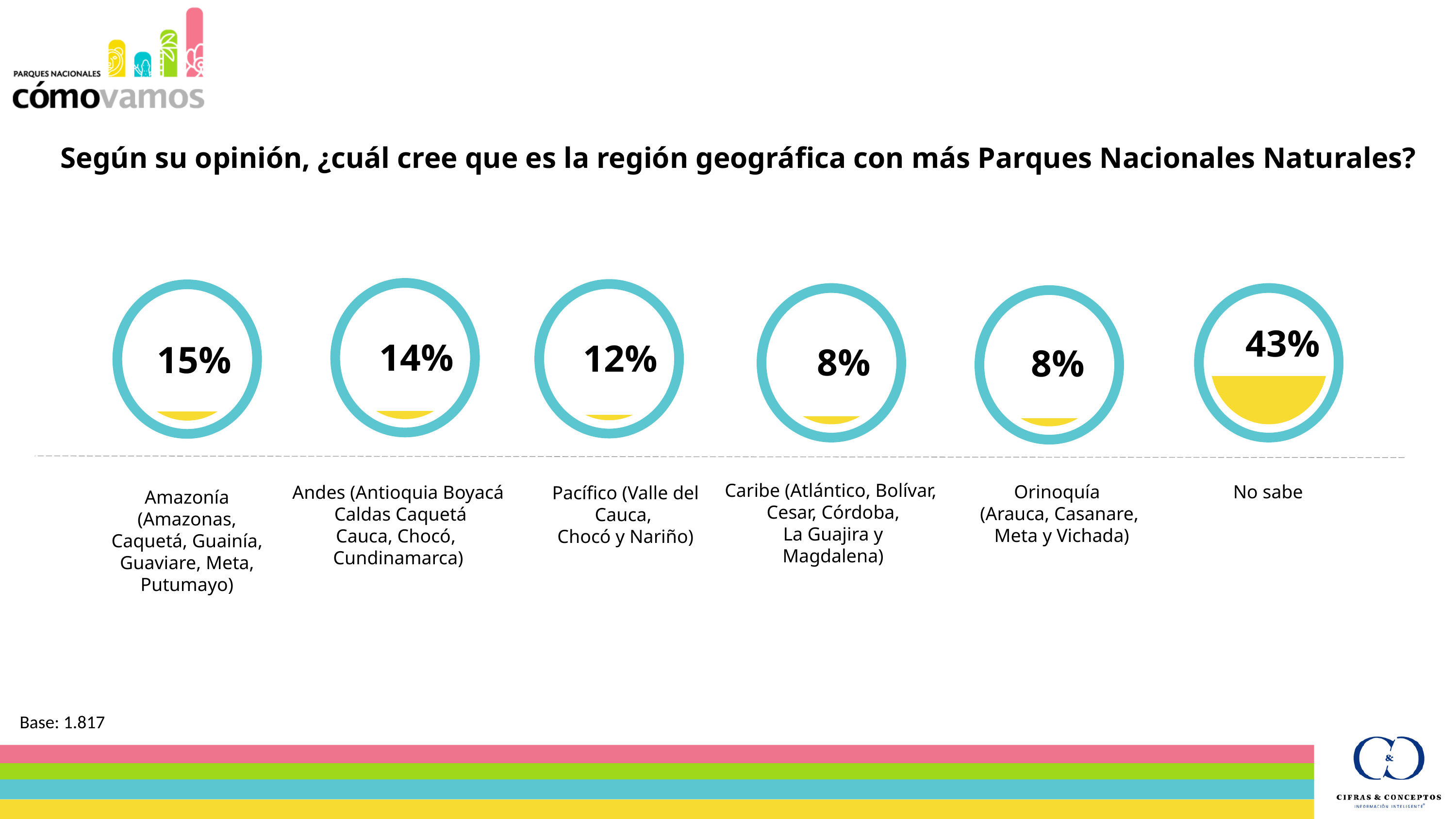
What percentage is shown for Pacífico? 12% What percentage of respondents chose Amazonía as the region with the most Parques Nacionales Naturales? 15% What is the difference in percentage points between 'No sabe' and Amazonía? 28 What is the base (number of respondents) stated on the slide? 1.817 Which two response options share the lowest percentage? Caribe and Orinoquía Which response option has the highest percentage? No sabe What percentage is shown for Caribe? 8% What percentage of respondents answered 'No sabe'? 43% Which has a larger percentage, Andes or Pacífico? Andes What percentage is shown for Andes? 14% Which region has the highest percentage among the named regions (excluding 'No sabe')? Amazonía How many response options are shown on the slide? 6